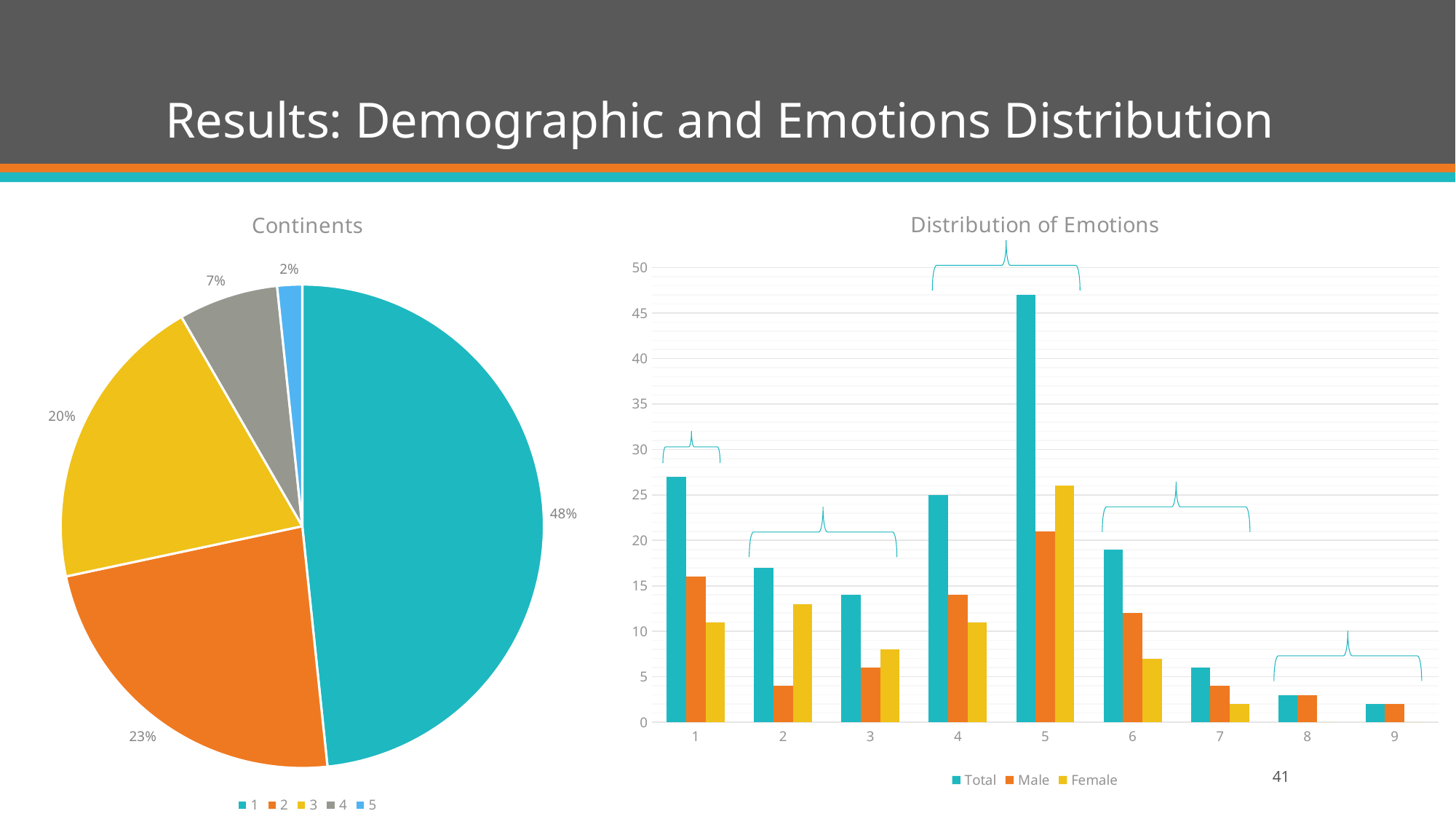
On the Continents pie chart, how many slices are there? 5 On the Distribution of Emotions chart, is the Male value for category 2 greater or less than 5? less On the Continents pie chart, what share does category 1 have? 48% What type of chart is the Continents chart? Pie chart On the Continents pie chart, which category has the largest share? 1 On the Distribution of Emotions chart, which category has the highest Total value? 5 On the Continents pie chart, which category has the smallest share? 5 On the Distribution of Emotions chart, is the Total value for category 5 greater or less than 45? greater On the Distribution of Emotions chart, how many categories are shown on the x axis? 9 On the Distribution of Emotions chart, how many series does the legend list? 3 On the Continents pie chart, what is the difference between the shares of category 2 and category 3? 3% On the Continents pie chart, what share does category 4 have? 7%